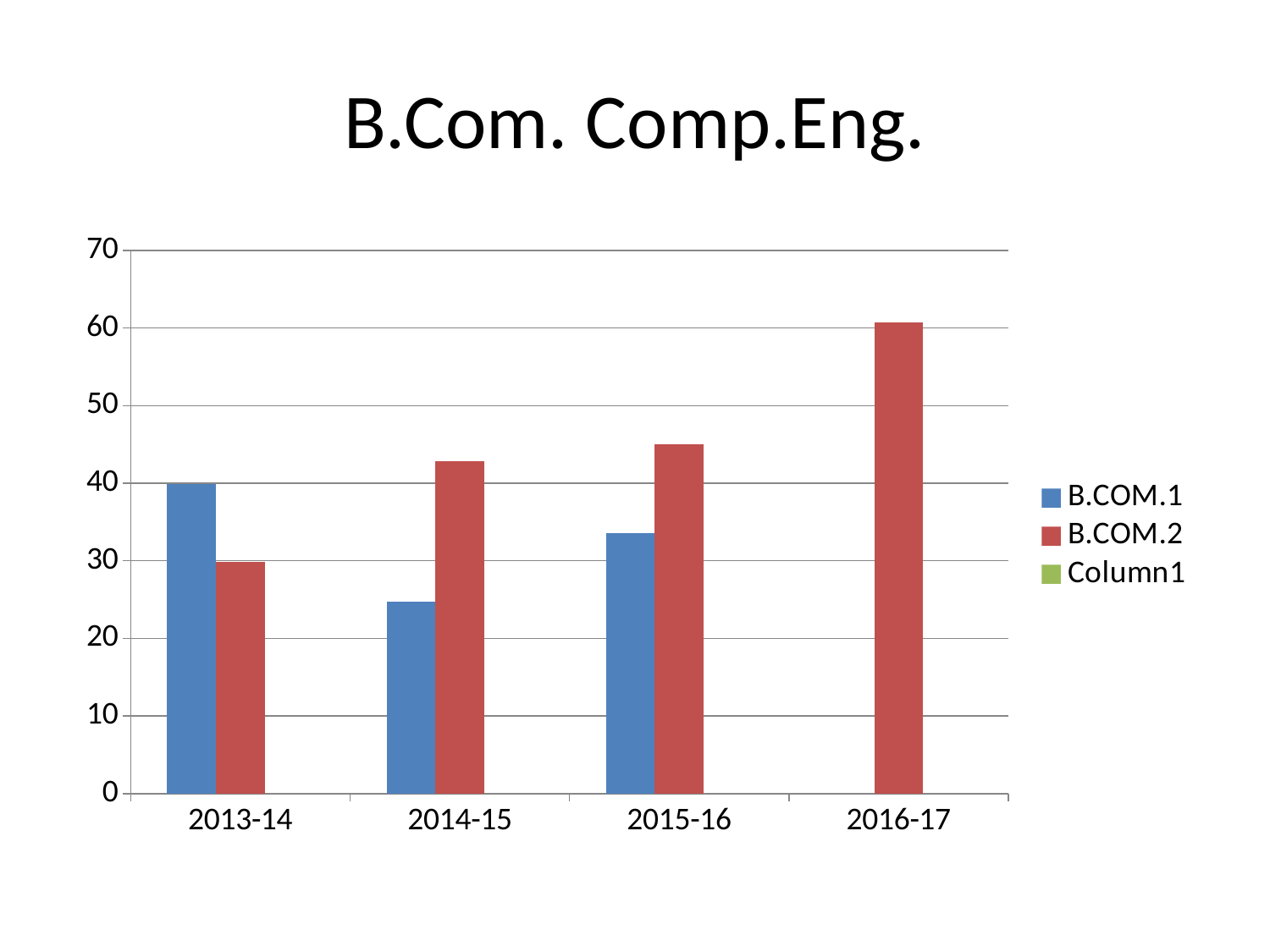
In which year is the B.COM.2 value lowest? 2013-14 In which year is the B.COM.1 value lowest? 2014-15 In which year is the B.COM.1 value highest? 2013-14 What kind of chart is shown on the slide? bar chart Is the B.COM.1 value for 2014-15 greater or less than 30? less Is the B.COM.2 value for 2016-17 greater or less than 50? greater In which year is the B.COM.2 value highest? 2016-17 How many year categories are shown on the x axis? 4 What is the title of the chart? B.Com. Comp.Eng. How many series does the legend list? 3 Do the B.COM.2 values rise or fall from 2013-14 to 2016-17? rise For 2013-14, which series has the larger value, B.COM.1 or B.COM.2? B.COM.1